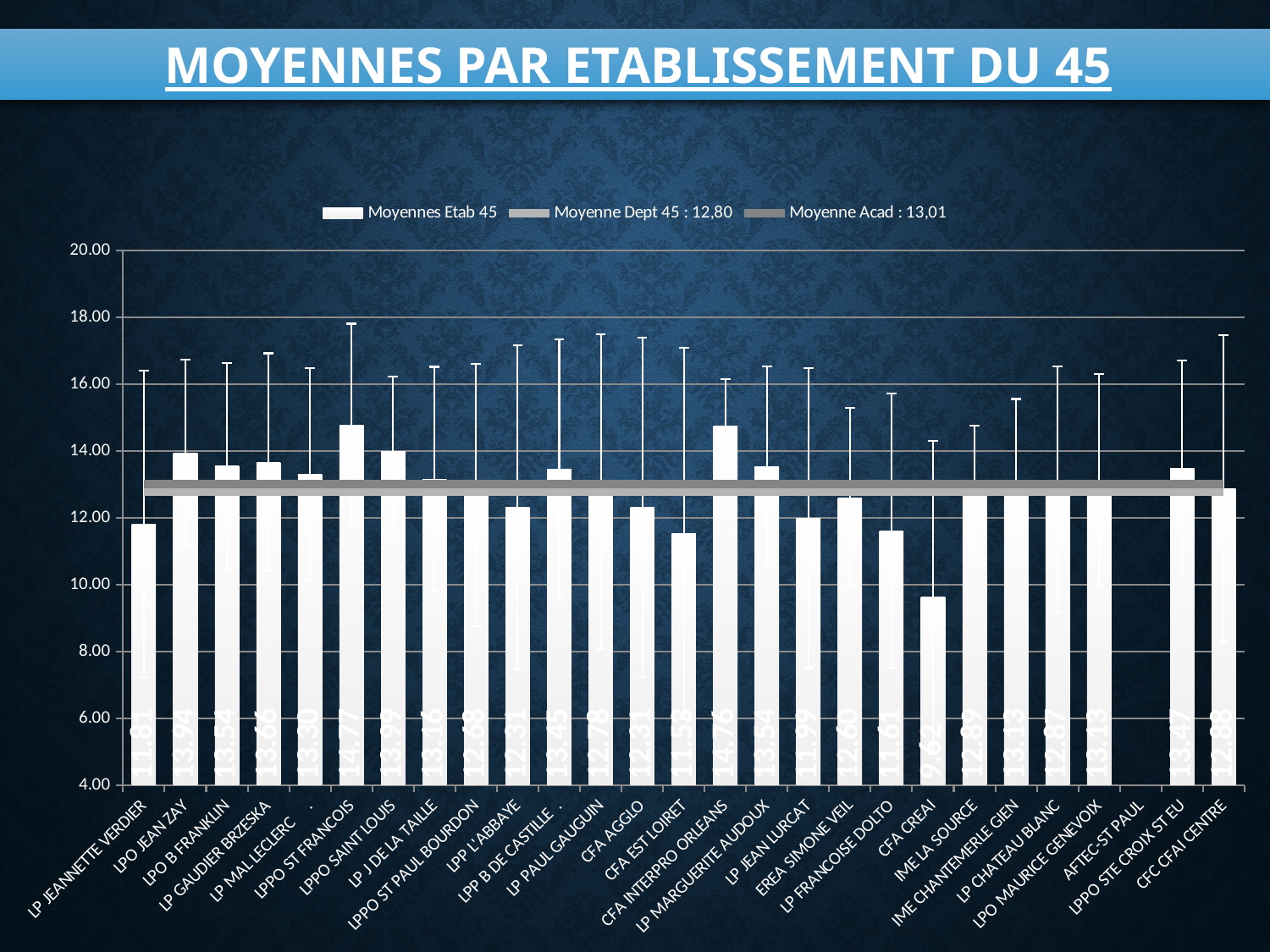
What type of chart is shown on the slide? bar chart What is the value for LP JEANNETTE VERDIER? 11.81 What is the difference between the values for LPO JEAN ZAY and LP JEANNETTE VERDIER? 2.13 How many series does the legend list? 3 Is the value for LPPO ST FRANCOIS greater or less than 14.00? greater What value does the legend give for Moyenne Dept 45? 12,80 What is the value for CFA CREAI? 9.62 Is the value for CFA CREAI greater or less than 10.00? less What is the value for LPO JEAN ZAY? 13.94 Which is larger, the value for LPPO ST FRANCOIS or the value for CFA CREAI? LPPO ST FRANCOIS Which establishment has the lowest value? CFA CREAI What is the title of the chart? MOYENNES PAR ETABLISSEMENT DU 45